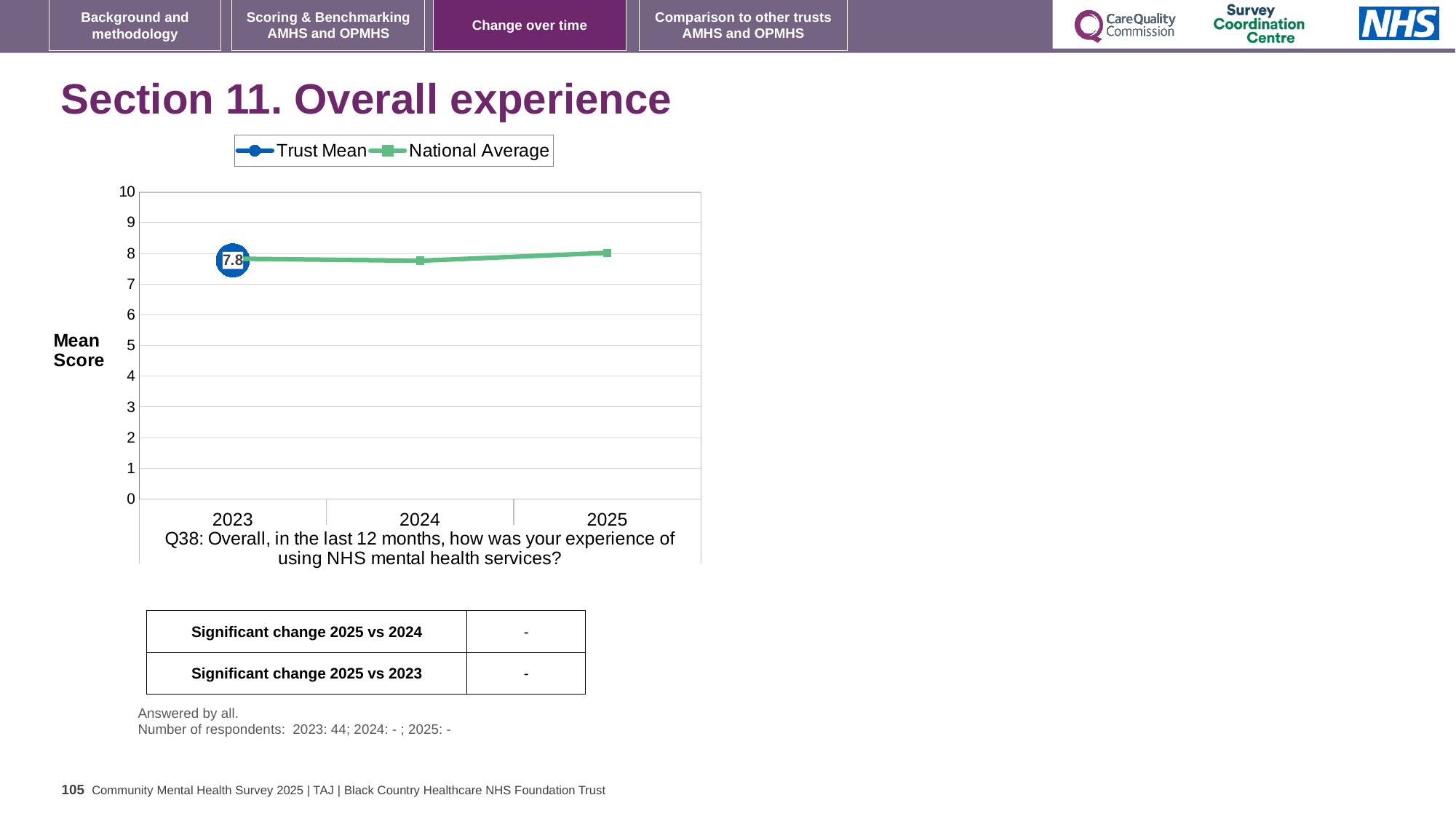
What kind of chart is shown on the slide? line chart How many series does the legend list? 2 What is the label on the y axis of the chart? Mean Score How many years are shown on the x axis? 3 What is the Trust Mean score for 2023? 7.8 Does the National Average rise or fall from 2024 to 2025? rise Is the National Average value for 2024 greater or less than 6? greater What is the highest value shown on the y axis? 10 Is the Trust Mean value for 2023 greater or less than 5? greater Is the National Average value for 2025 greater or less than 7? greater What are the two series named in the legend? Trust Mean and National Average For which year is a Trust Mean data label shown? 2023